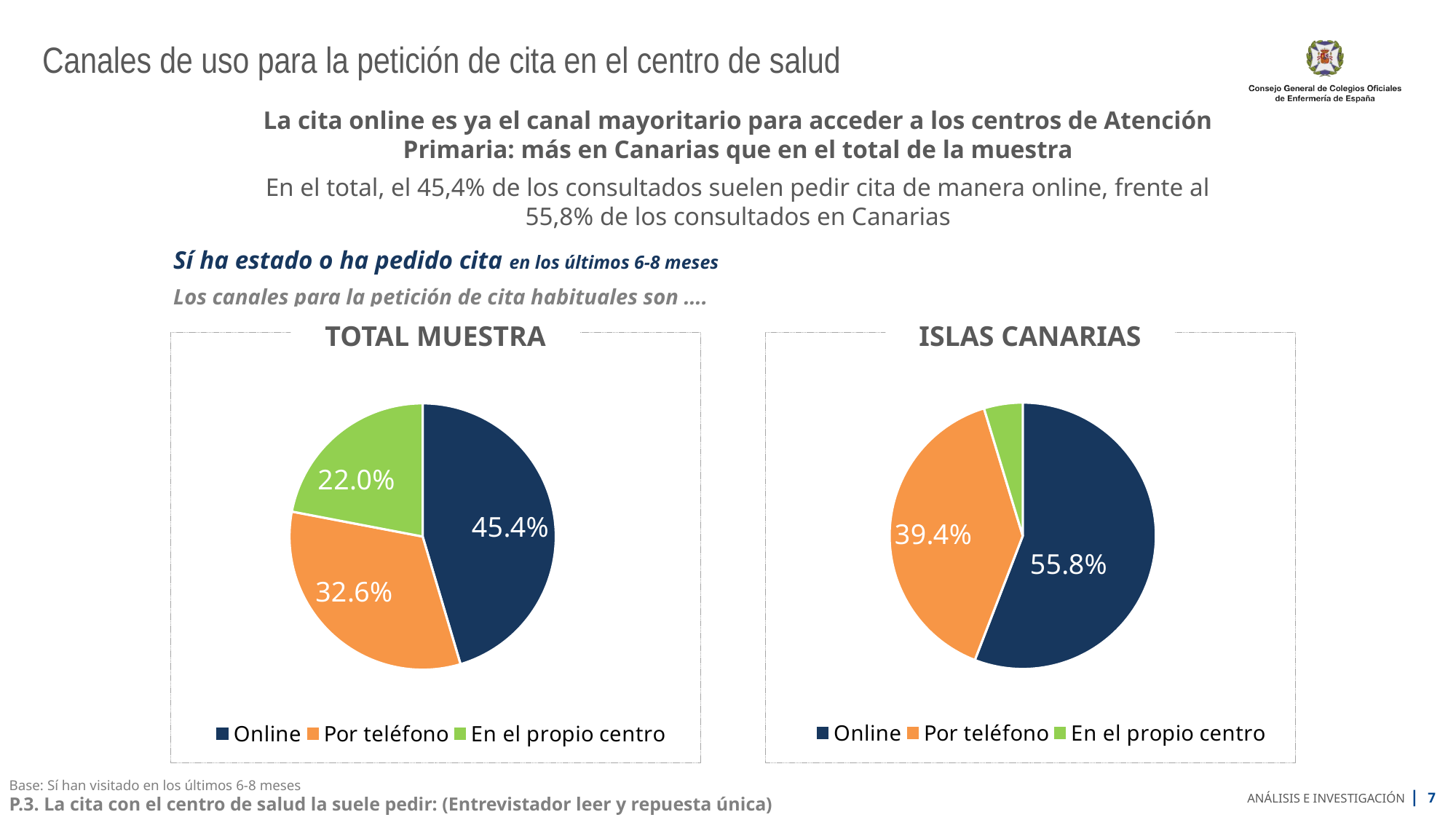
In the TOTAL MUESTRA chart, what is the value for En el propio centro? 22.0% What type of chart is used for TOTAL MUESTRA? Pie chart How many categories does the legend of the ISLAS CANARIAS chart list? 3 What is the difference between the Online share in the ISLAS CANARIAS chart and the Online share in the TOTAL MUESTRA chart? 10.4 percentage points In the ISLAS CANARIAS chart, which channel has the smallest slice? En el propio centro In the ISLAS CANARIAS chart, what is the value for Online? 55.8% In the TOTAL MUESTRA chart, what share of respondents request appointments online? 45.4% In the TOTAL MUESTRA chart, what is the difference between the Por teléfono and En el propio centro shares? 10.6 percentage points In the TOTAL MUESTRA chart, what is the value for Por teléfono? 32.6% In the TOTAL MUESTRA chart, which channel has the largest slice? Online Which is larger: the Por teléfono share in the TOTAL MUESTRA chart or the Por teléfono share in the ISLAS CANARIAS chart? ISLAS CANARIAS In the ISLAS CANARIAS chart, what is the value for Por teléfono? 39.4%